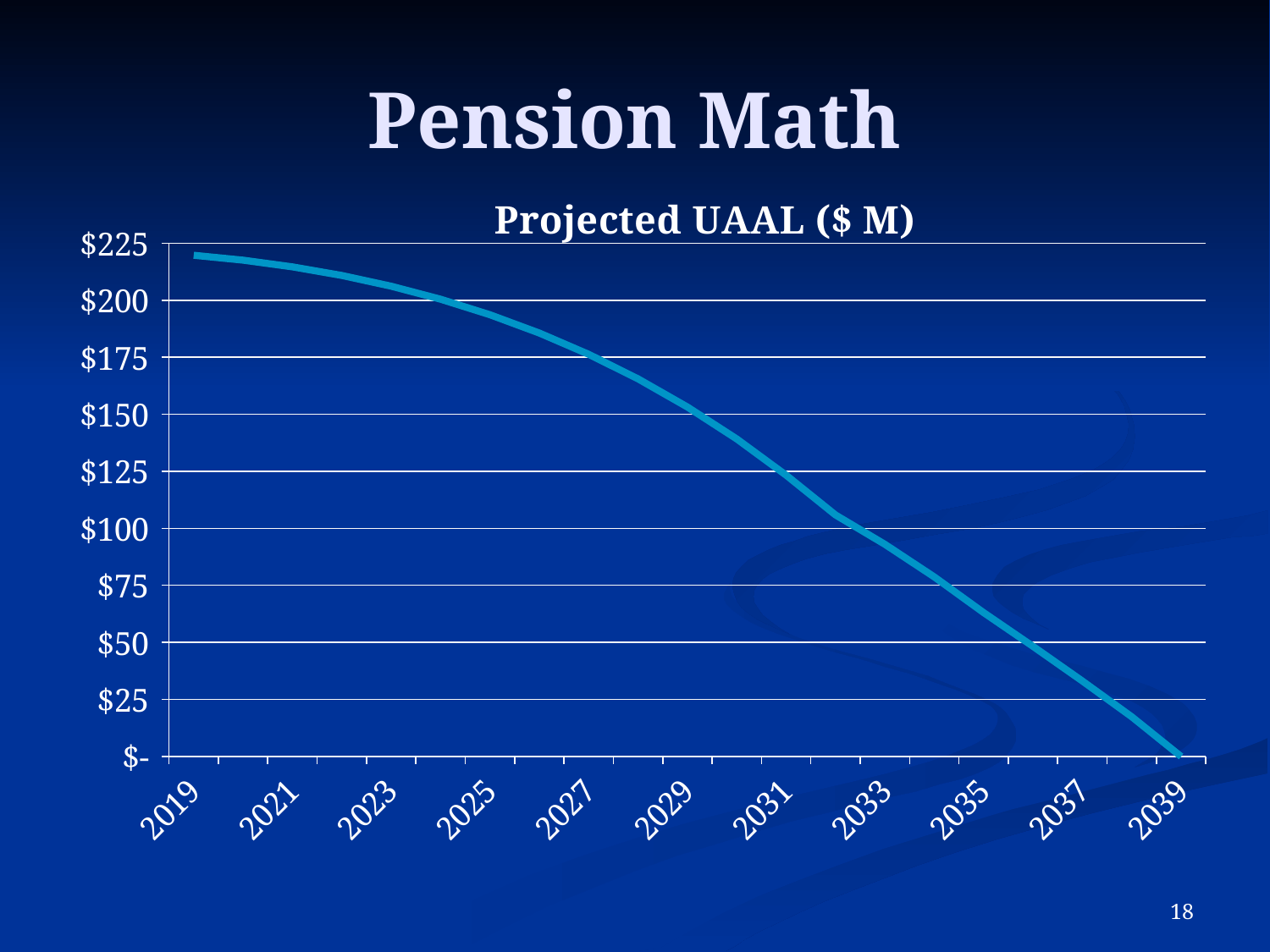
Is the value for 2019 greater or less than $200? greater What is the first year shown on the x axis? 2019 What is the title of the chart? Projected UAAL ($ M) Is the value for 2023 greater or less than $200? greater Is the value for 2039 greater or less than $25? less Which year has the lowest projected UAAL? 2039 How many years are labeled on the x axis? 11 Do the values rise or fall from 2019 to 2039? fall Which is larger, the value for 2021 or the value for 2037? 2021 Which year has the highest projected UAAL? 2019 What kind of chart is shown on the slide? line chart